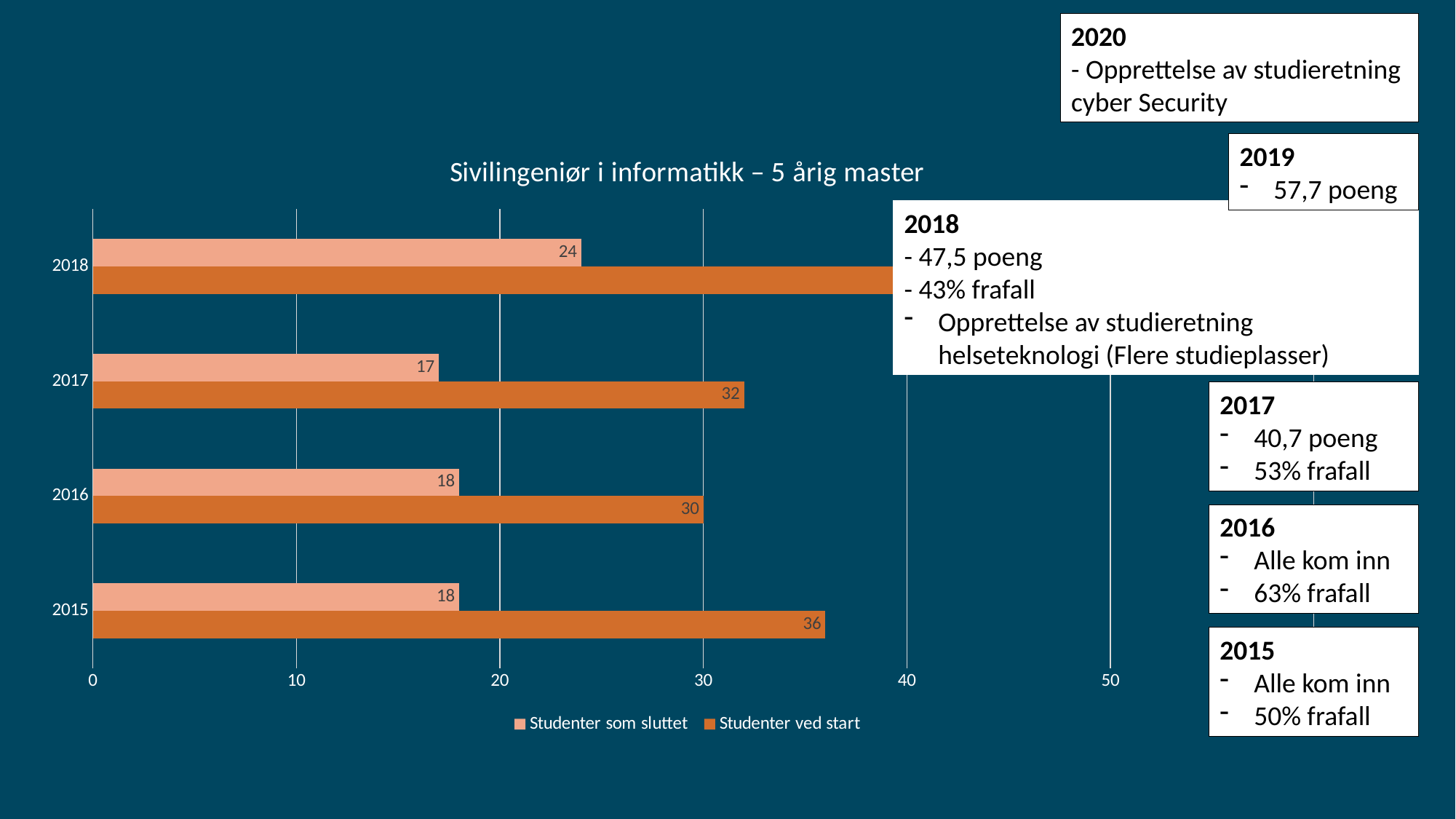
How many years (categories) are shown on the chart? 4 What type of chart is shown on the slide? bar chart How many series does the chart legend list? 2 What is the value of 'Studenter som sluttet' for 2018? 24 What is the value of 'Studenter ved start' for 2016? 30 Which is larger: 'Studenter ved start' for 2017 or 'Studenter ved start' for 2016? 2017 What is the title of the chart? Sivilingeniør i informatikk – 5 årig master Which year has the highest value for 'Studenter som sluttet'? 2018 What is the value of 'Studenter som sluttet' for 2017? 17 What is the difference between 'Studenter ved start' and 'Studenter som sluttet' for 2015? 18 What is the value of 'Studenter ved start' for 2015? 36